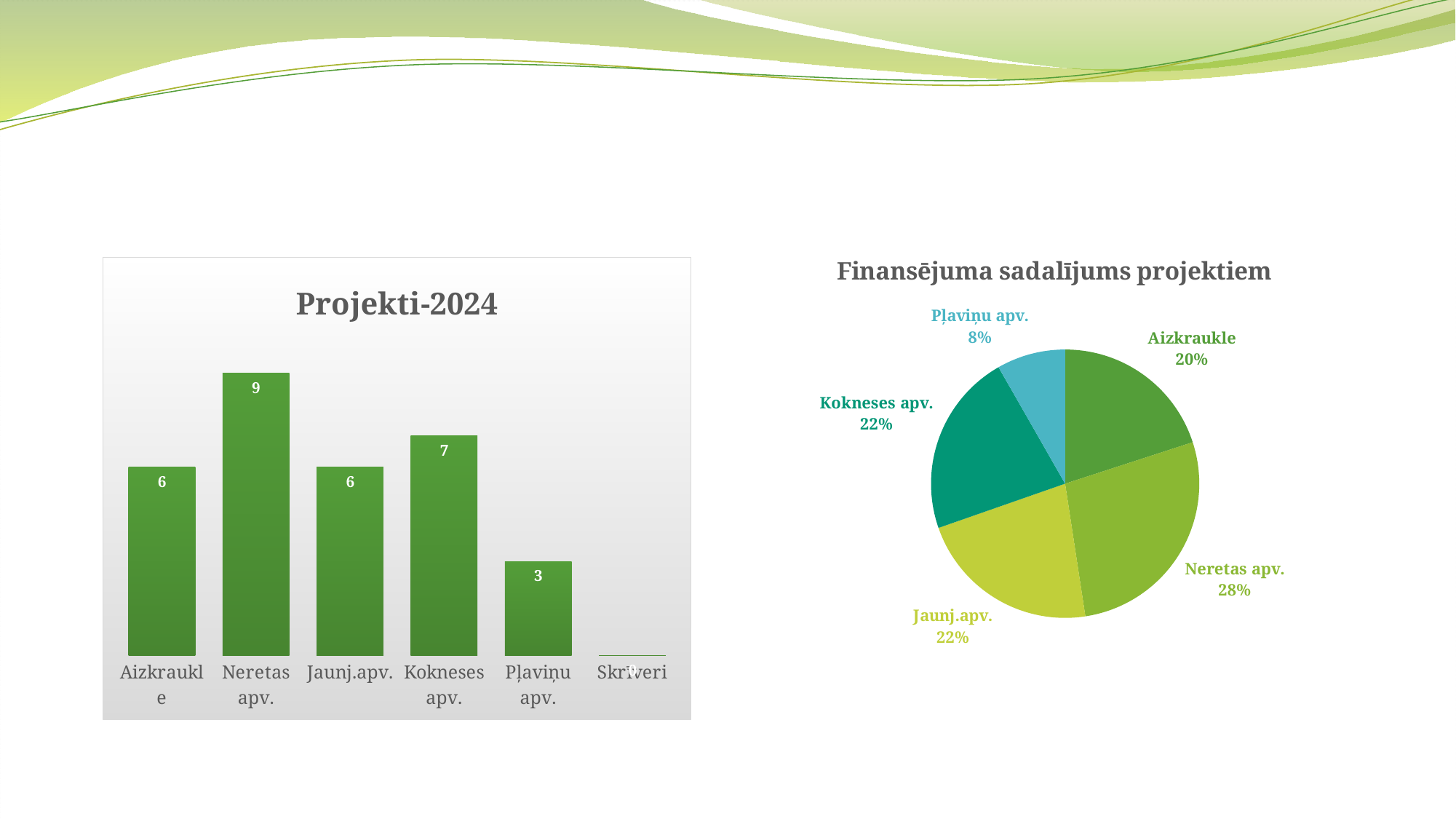
In the Projekti-2024 chart, what is the value for Neretas apv.? 9 In the Finansējuma sadalījums projektiem chart, what share does Pļaviņu apv. have? 8% In the Finansējuma sadalījums projektiem chart, what share does Neretas apv. have? 28% In the Projekti-2024 chart, what is the value for Pļaviņu apv.? 3 What kind of chart is the Finansējuma sadalījums projektiem chart? pie chart In the Projekti-2024 chart, which category has the highest value? Neretas apv. In the Projekti-2024 chart, which category has the lowest value? Skrīveri In the Projekti-2024 chart, what is the difference between the values for Neretas apv. and Pļaviņu apv.? 6 In the Projekti-2024 chart, what is the value for Kokneses apv.? 7 In the Projekti-2024 chart, how many categories are shown on the x axis? 6 What kind of chart is the Projekti-2024 chart? bar chart In the Finansējuma sadalījums projektiem chart, which is larger, the share for Aizkraukle or the share for Kokneses apv.? Kokneses apv.